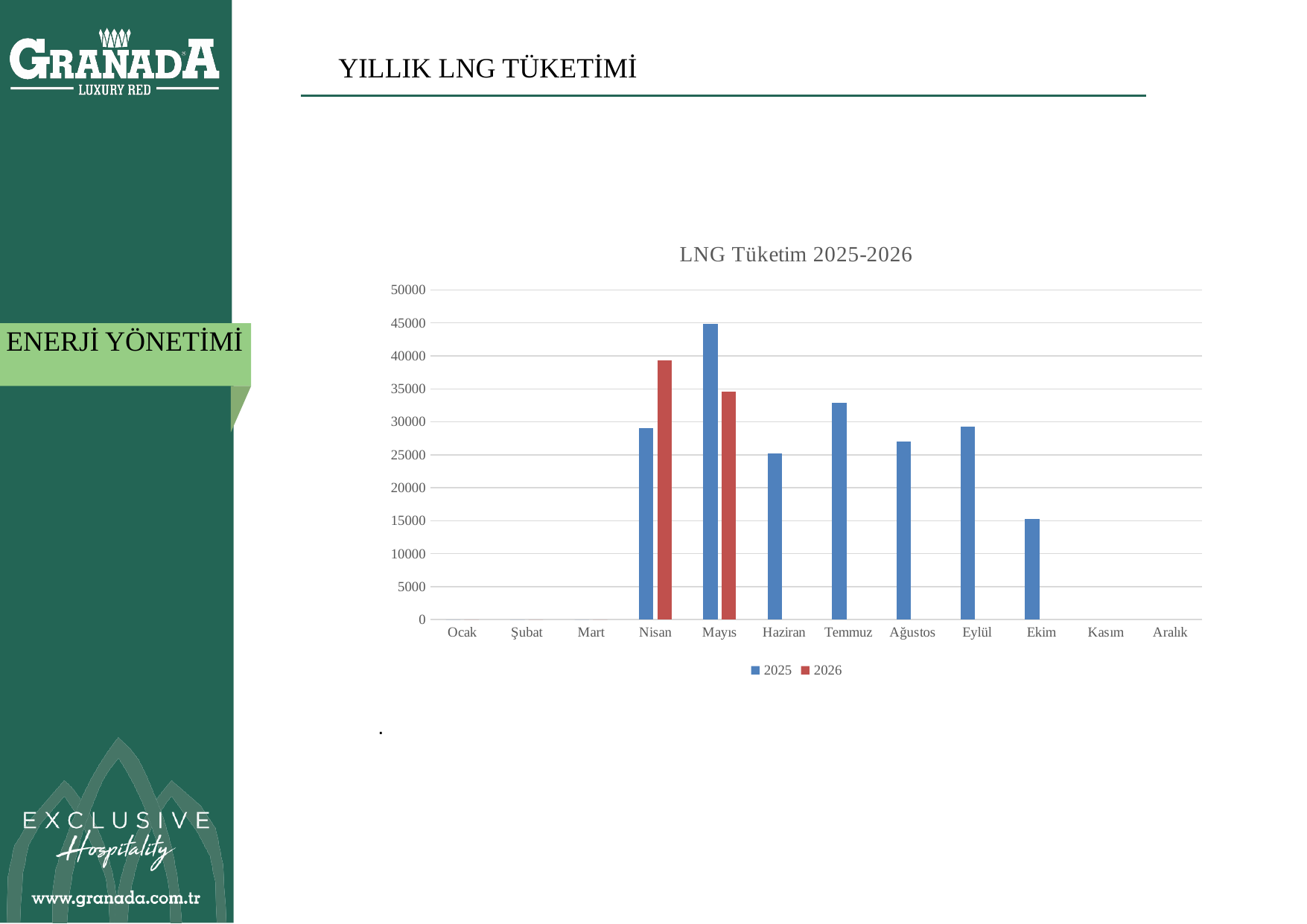
Is the 2026 value for Nisan greater or less than 35000? greater For Mayıs, which series has the larger value, 2025 or 2026? 2025 Which month has the tallest 2025 bar? Mayıs Among the months that have a 2025 bar, which month has the lowest 2025 value? Ekim How many month categories are shown on the x axis? 12 Is the 2025 value for Mayıs greater or less than 40000? greater How many series does the legend list? 2 What is the title of the chart? LNG Tüketim 2025-2026 Is the 2025 value for Ekim greater or less than 20000? less For Nisan, which series has the larger value, 2025 or 2026? 2026 Which month has the larger 2025 value, Temmuz or Ağustos? Temmuz What kind of chart is shown on the slide? bar chart